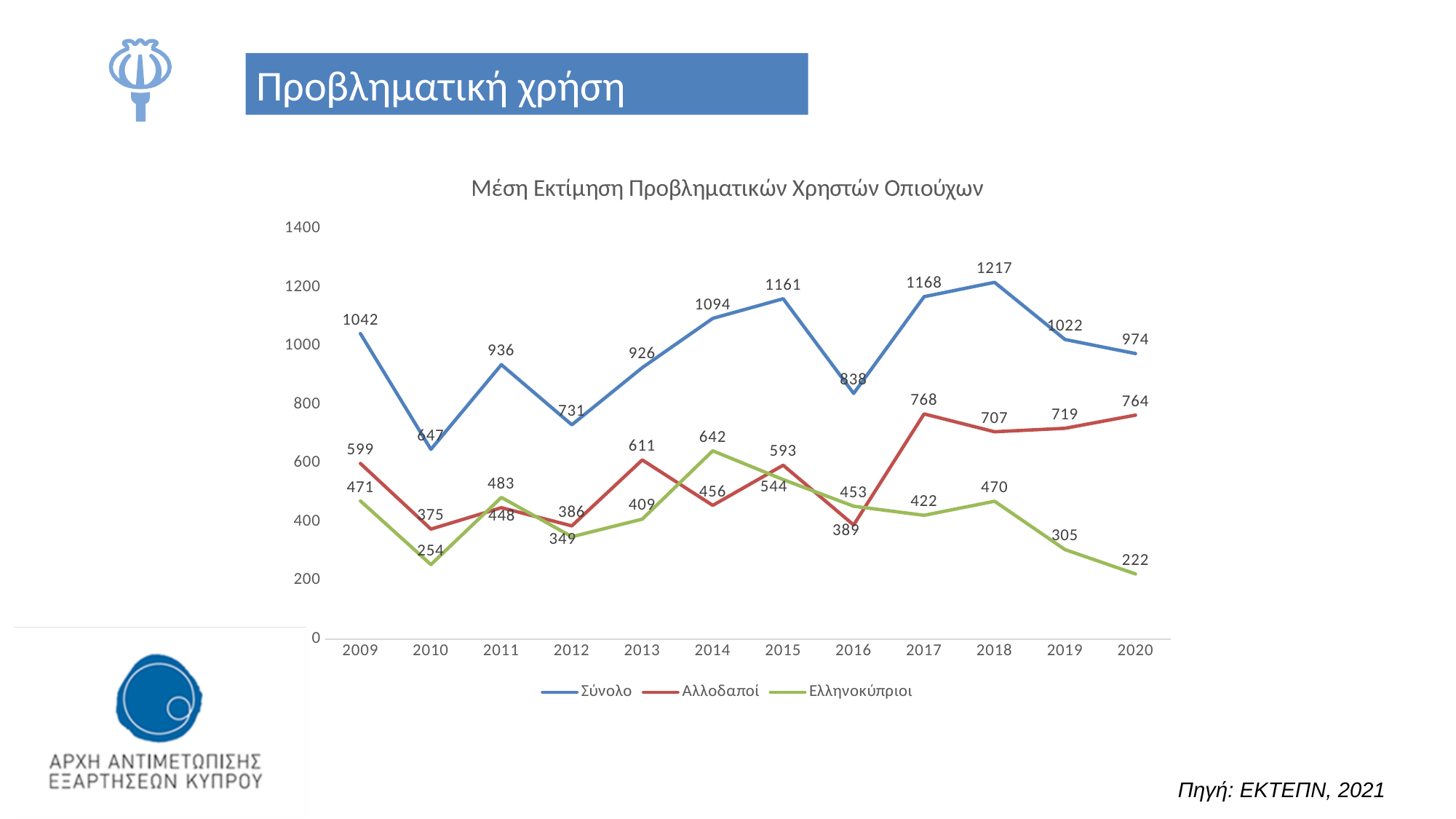
What is the value of Αλλοδαποί in 2013? 611 Does Ελληνοκύπριοι rise or fall from 2018 to 2020? fall How many series does the legend list? 3 Which is larger in 2014, Αλλοδαποί or Ελληνοκύπριοι? Ελληνοκύπριοι What is the value of Ελληνοκύπριοι in 2020? 222 What is the title of the chart? Μέση Εκτίμηση Προβληματικών Χρηστών Οπιούχων In which year is Ελληνοκύπριοι at its lowest? 2020 What is the value of Σύνολο in 2018? 1217 What type of chart is shown on the slide? line chart What is the difference between Σύνολο in 2009 and Σύνολο in 2010? 395 How many years are shown on the x axis? 12 In which year is Σύνολο at its highest? 2018